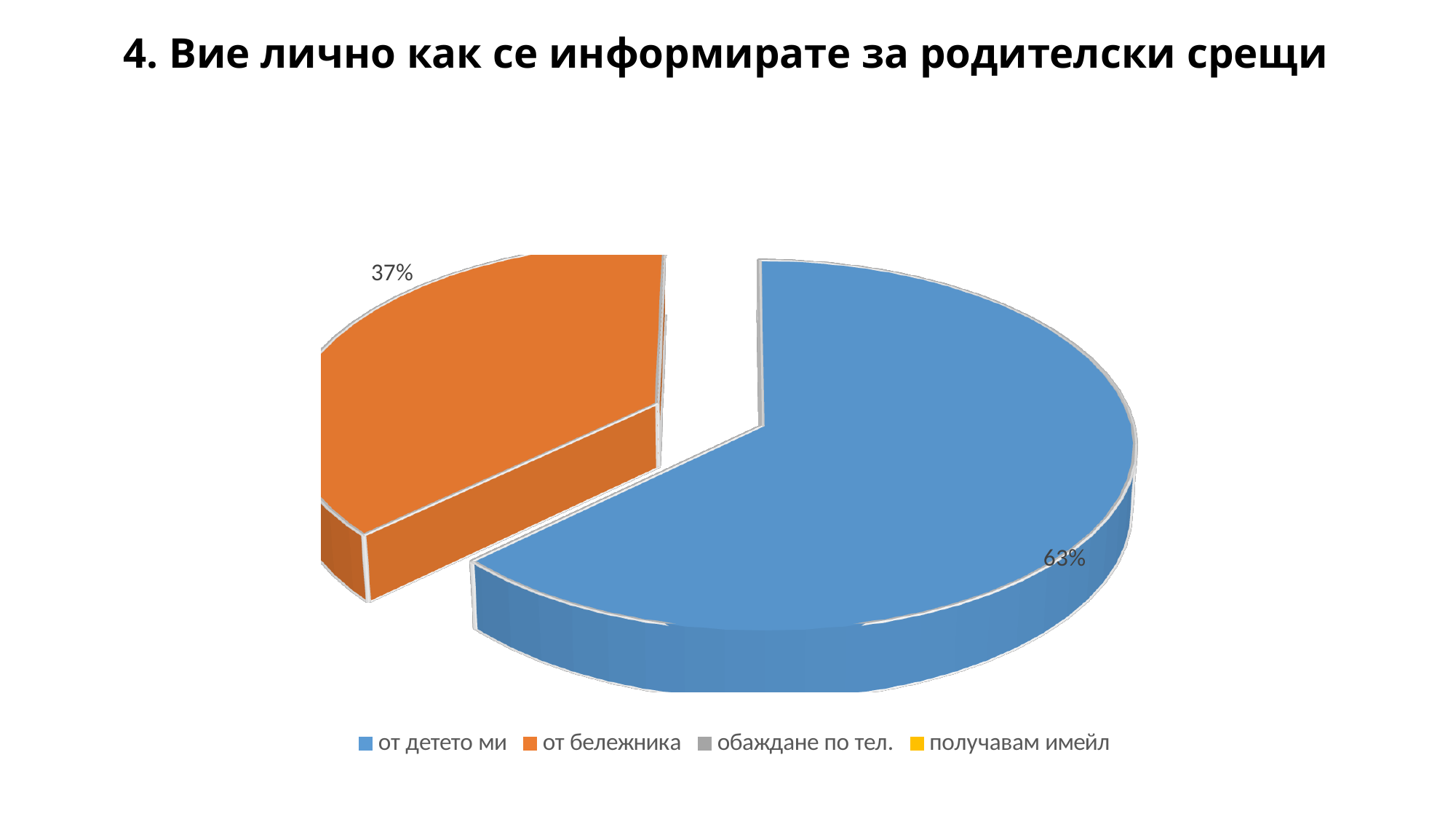
What colour is the slice for "от бележника"? Orange How many slices with data labels are visible in the pie? 2 Which category has the largest slice of the pie? от детето ми What percentage of the pie is labelled for "от детето ми"? 63% What is the title of the chart? 4. Вие лично как се информирате за родителски срещи How many entries does the legend list? 4 Is the share for "от детето ми" greater or less than 50%? greater Is the share for "от бележника" greater or less than 50%? less What kind of chart is shown on the slide? Pie chart What percentage of the pie is labelled for "от бележника"? 37% By how many percentage points does the "от детето ми" slice exceed the "от бележника" slice? 26% Which of the two labelled slices is larger, "от детето ми" or "от бележника"? от детето ми